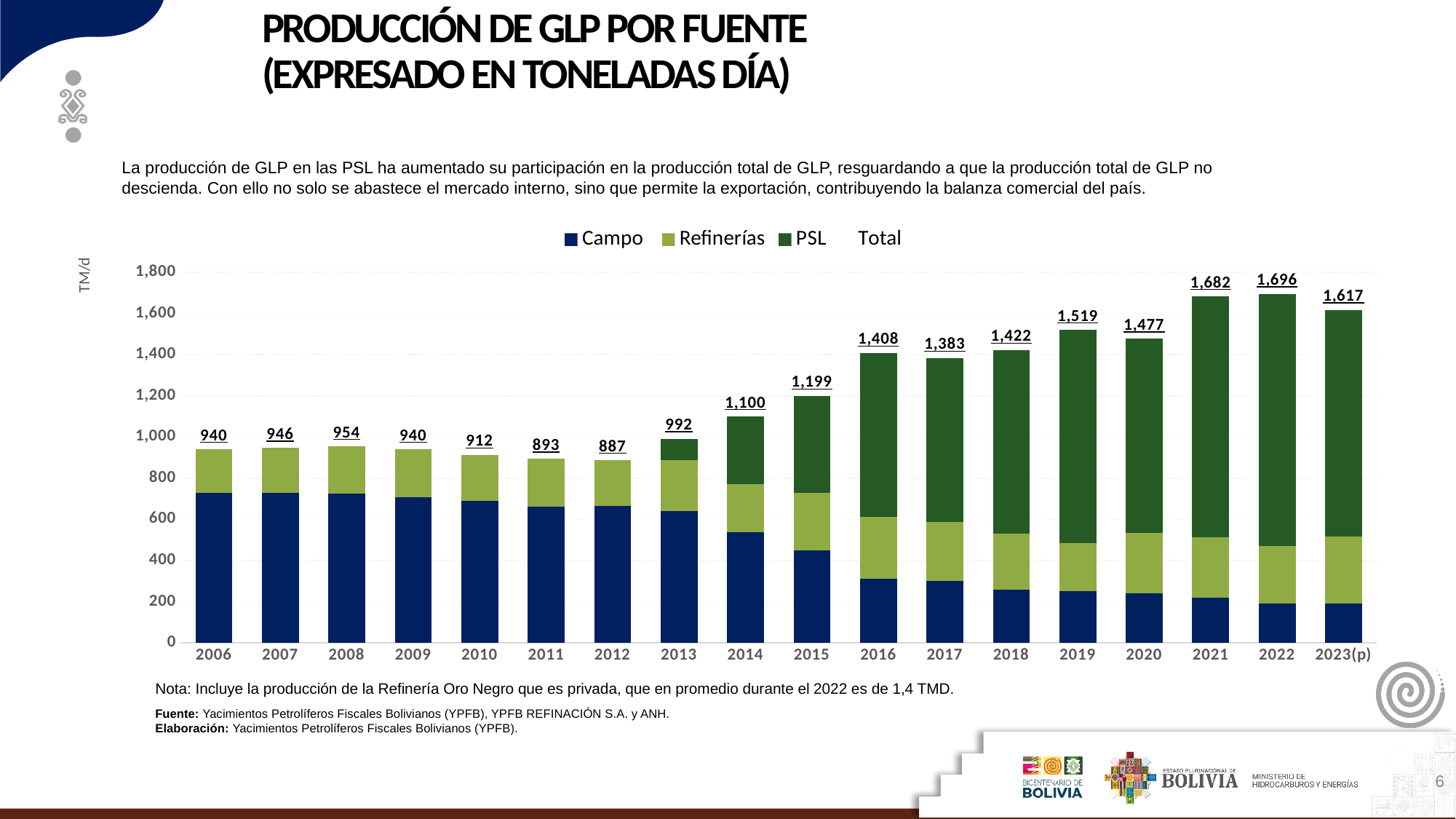
Which year has the highest total GLP production? 2022 Is the Campo value for 2006 greater or less than 600? greater How many years are shown on the x axis? 18 By how much did the total fall from 2022 to 2023(p)? 79 What is the total value labelled for 2023(p)? 1,617 What kind of chart is shown on the slide? Stacked bar chart Which year has the lowest total GLP production? 2012 What is the difference between the total for 2022 and the total for 2021? 14 What is the total GLP production shown for 2022? 1,696 Is the Campo value for 2023(p) greater or less than 400? less What is the total value labelled for 2012? 887 Which total is larger, 2016 or 2017? 2016